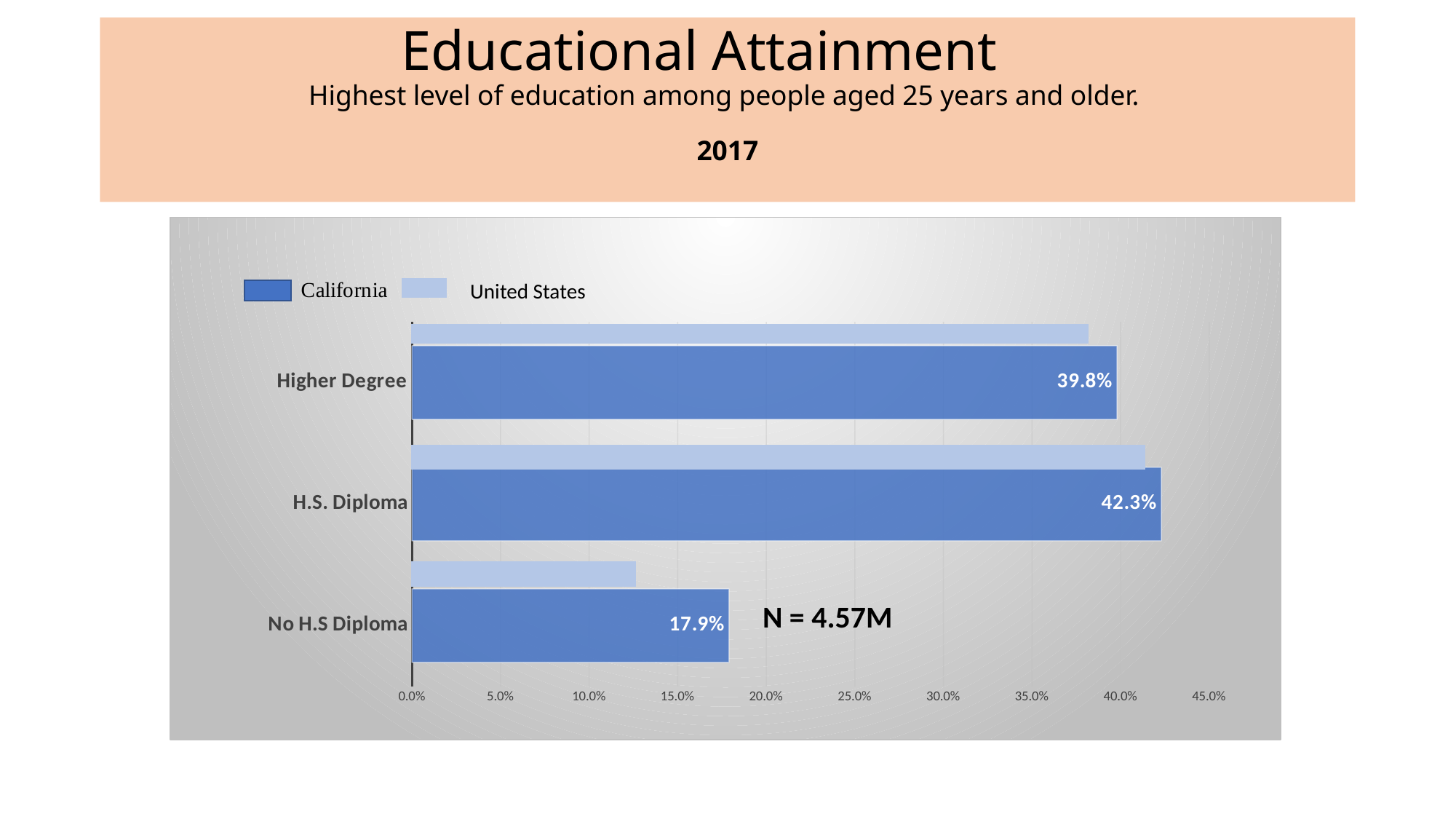
Is the United States value for Higher Degree greater or less than 35.0%? greater How many series does the legend list? 2 What is the difference between California's Higher Degree value and its No H.S Diploma value? 21.9% Is the United States value for No H.S Diploma greater or less than 15.0%? less Which category has the highest value for California? H.S. Diploma What is the value for California in the Higher Degree category? 39.8% What is the difference between California's H.S. Diploma value and its Higher Degree value? 2.5% What is the value for California in the No H.S Diploma category? 17.9% What is the value for California in the H.S. Diploma category? 42.3% How many education categories are shown on the chart? 3 Which category has the lowest value for California? No H.S Diploma In the No H.S Diploma category, which is larger: California or United States? California